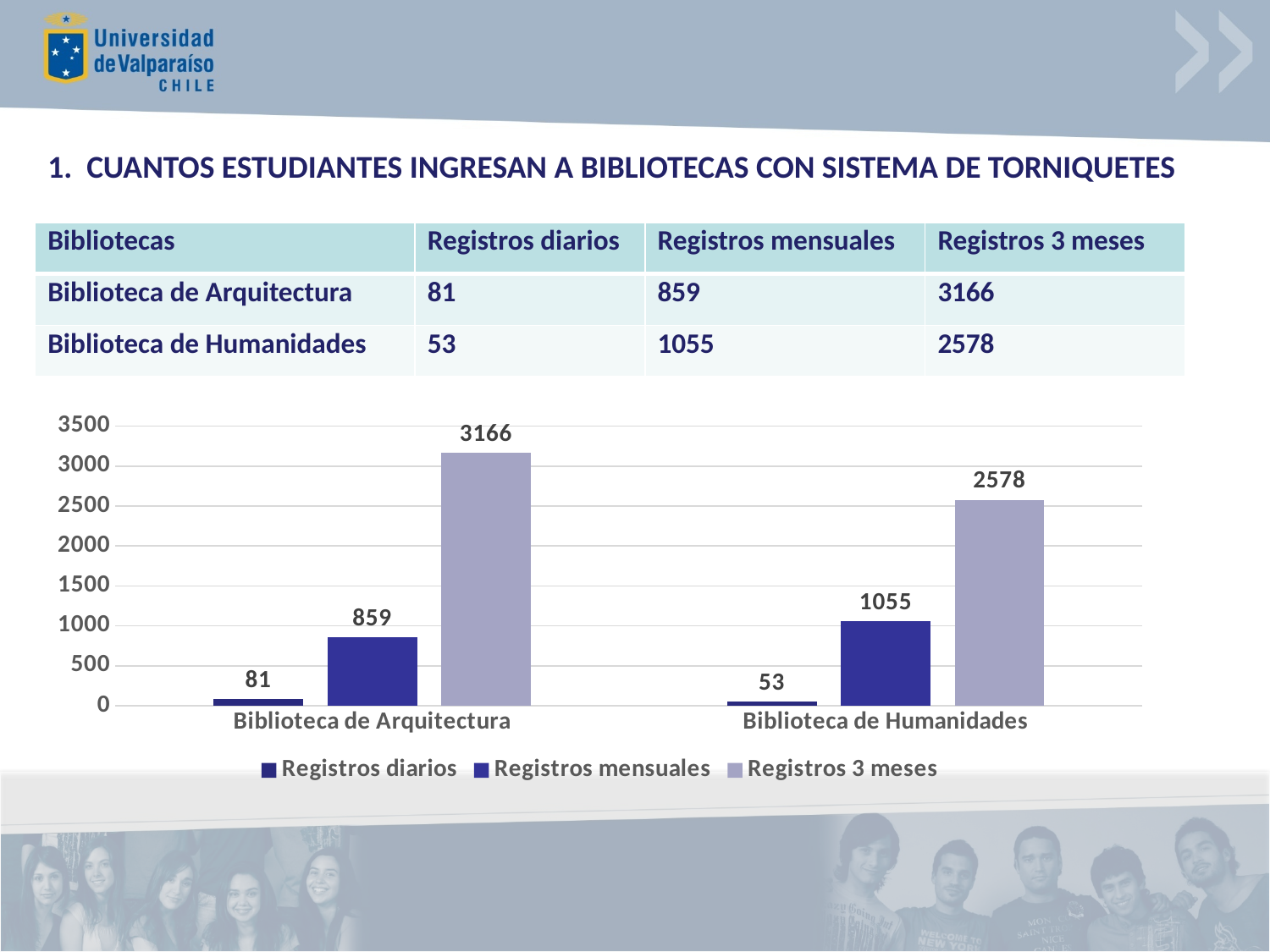
How many series does the chart legend list? 3 What is the value of Registros mensuales for Biblioteca de Humanidades? 1055 Is the value of Registros 3 meses for Biblioteca de Humanidades greater or less than 3000? less How many libraries are shown on the x axis of the chart? 2 Which is larger: Registros mensuales for Biblioteca de Arquitectura or for Biblioteca de Humanidades? Biblioteca de Humanidades What is the value of Registros diarios for Biblioteca de Arquitectura? 81 What is the value of Registros 3 meses for Biblioteca de Arquitectura? 3166 What is the difference in Registros mensuales between Biblioteca de Humanidades and Biblioteca de Arquitectura? 196 Which library has the higher value for Registros 3 meses? Biblioteca de Arquitectura What type of chart is shown on the slide? Bar chart What is the difference in Registros 3 meses between Biblioteca de Arquitectura and Biblioteca de Humanidades? 588 Which library has the lower value for Registros diarios? Biblioteca de Humanidades